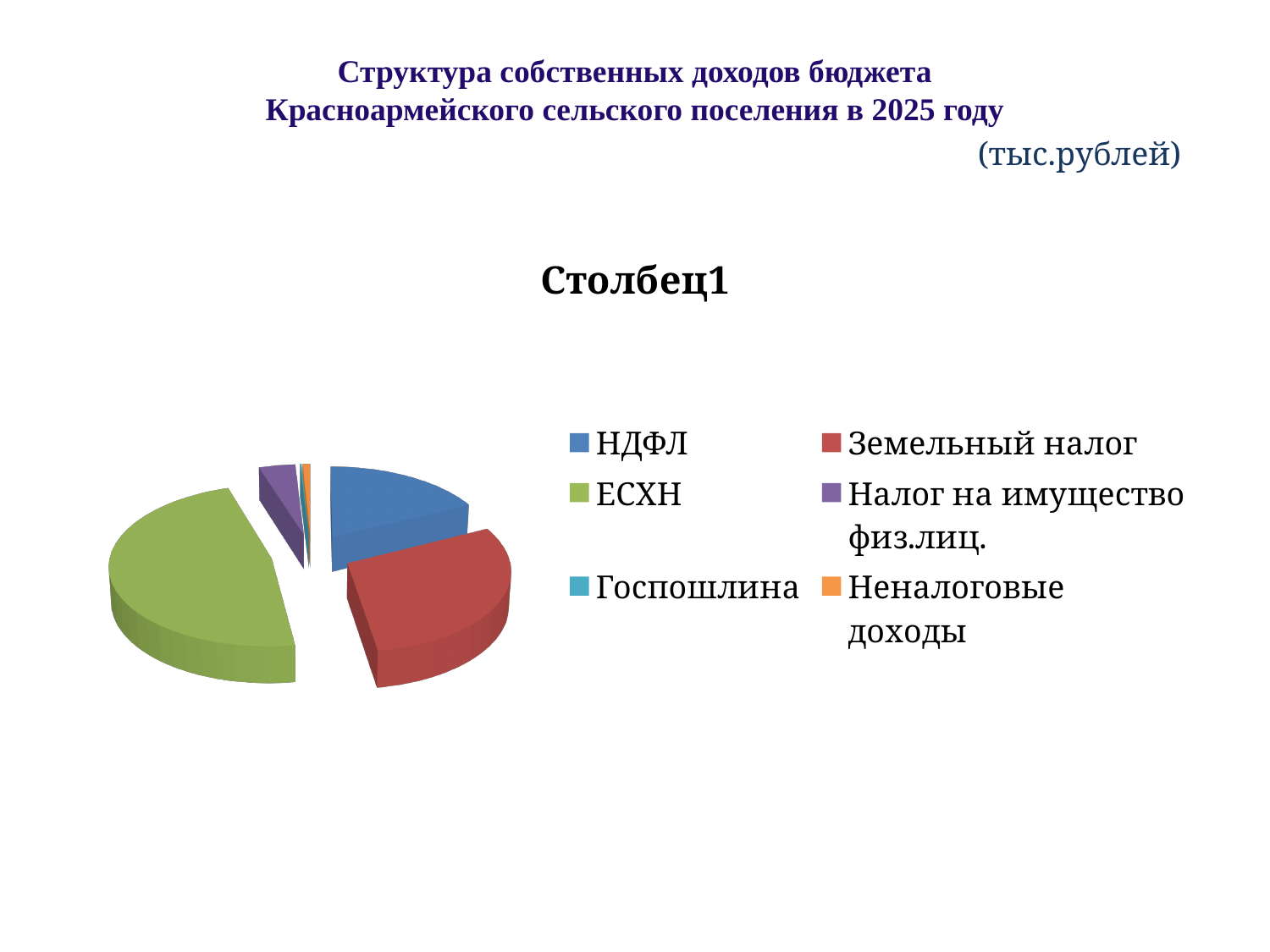
What kind of chart is shown on the slide? pie chart Which is larger in the pie chart, НДФЛ or Неналоговые доходы? НДФЛ Which is larger in the pie chart, Земельный налог or Налог на имущество физ.лиц.? Земельный налог What is the title shown above the pie chart? Столбец1 How many slices does the pie chart have? 6 Which is larger in the pie chart, ЕСХН or НДФЛ? ЕСХН What colour is the ЕСХН slice in the pie chart? green Which category has the largest slice in the pie chart? ЕСХН